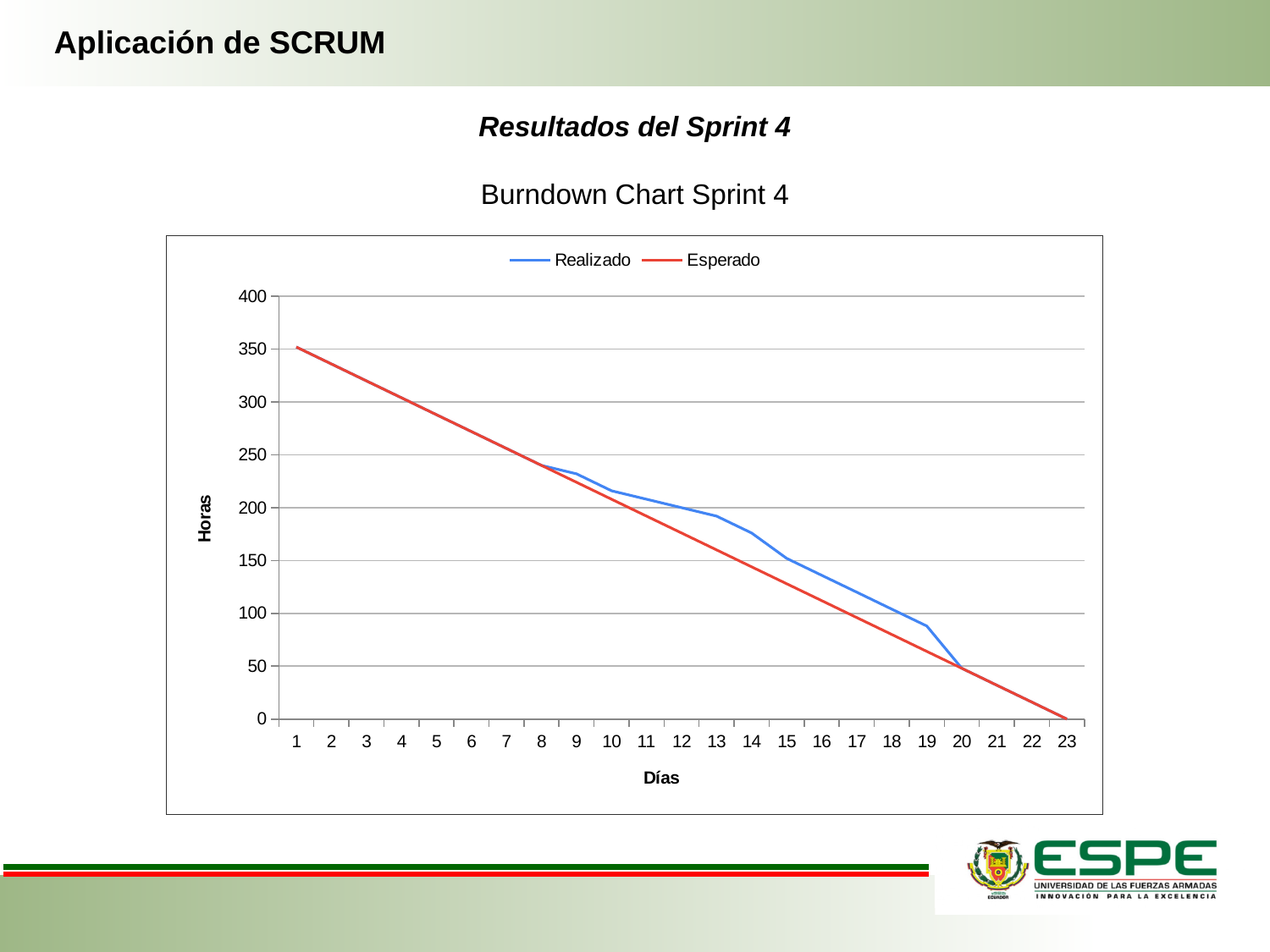
Do the Esperado values rise or fall from day 1 to day 23? fall What are the two series named in the legend? Realizado and Esperado How many days are shown on the x axis? 23 How many series does the legend list? 2 What is the title of the chart? Burndown Chart Sprint 4 Is the Esperado value on day 12 greater or less than 200? less On day 15, which series has the higher value, Realizado or Esperado? Realizado Is the Realizado value on day 13 greater or less than 150? greater What kind of chart is shown on the slide? line chart Is the Realizado value on day 9 greater or less than 200? greater What is the Esperado value on day 23? 0